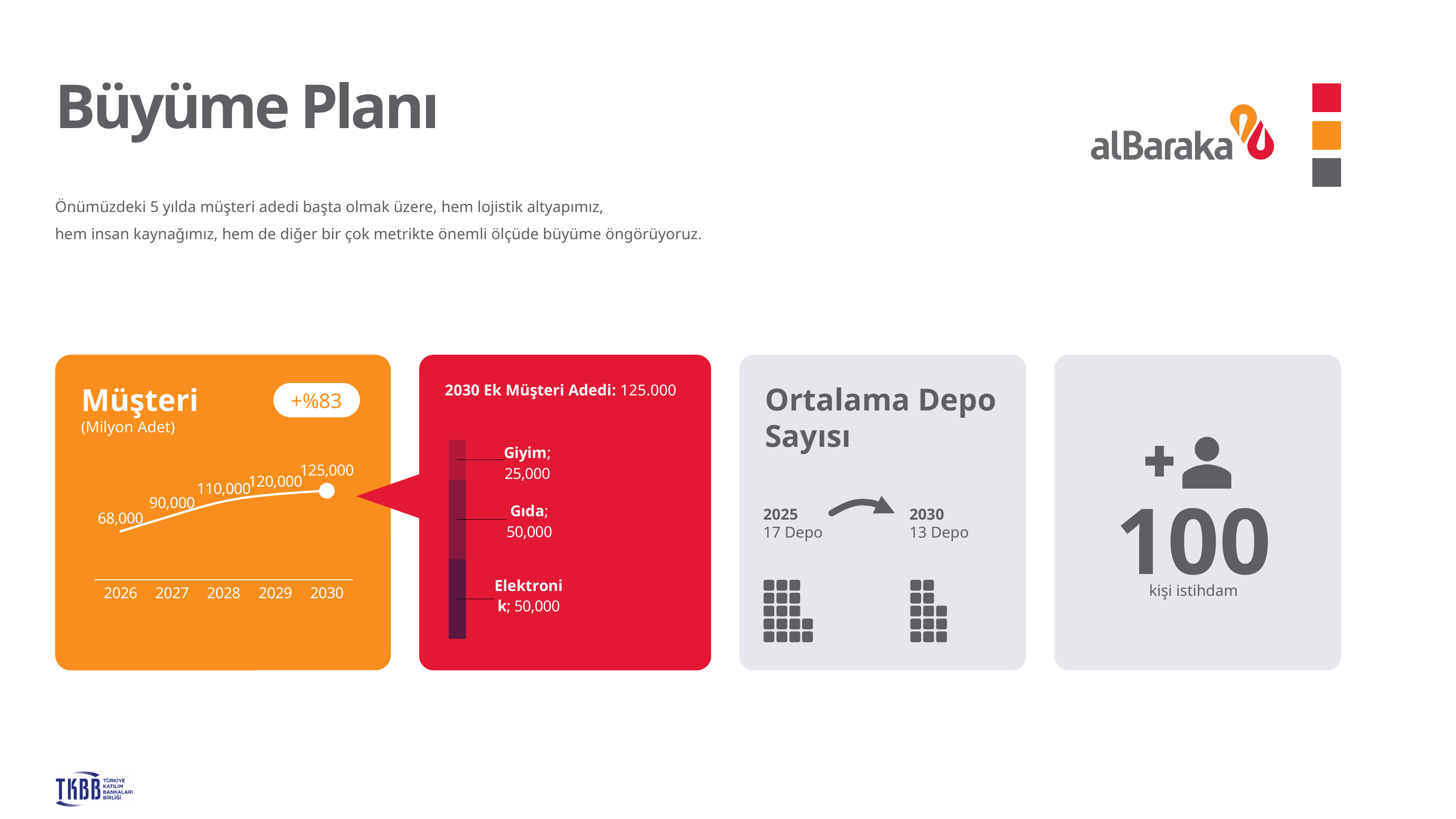
What kind of chart is shown in the orange Müşteri box? line chart In the Müşteri line chart, do the values rise or fall from 2026 to 2030? rise In the stacked bar in the red box, which segment is the smallest? Giyim In the Müşteri line chart, what is the value for 2028? 110,000 In the Müşteri line chart, what is the value for 2026? 68,000 In the Müşteri line chart, what is the value for 2030? 125,000 In the Müşteri line chart, which year has the highest value? 2030 How many years are plotted in the Müşteri line chart? 5 In the stacked bar in the red box, what is the total of all segments? 125,000 In the stacked bar in the red box, what is the value for Giyim? 25,000 In the Müşteri line chart, what is the difference between the 2027 and 2026 values? 22,000 In the Müşteri line chart, which year has the lowest value? 2026